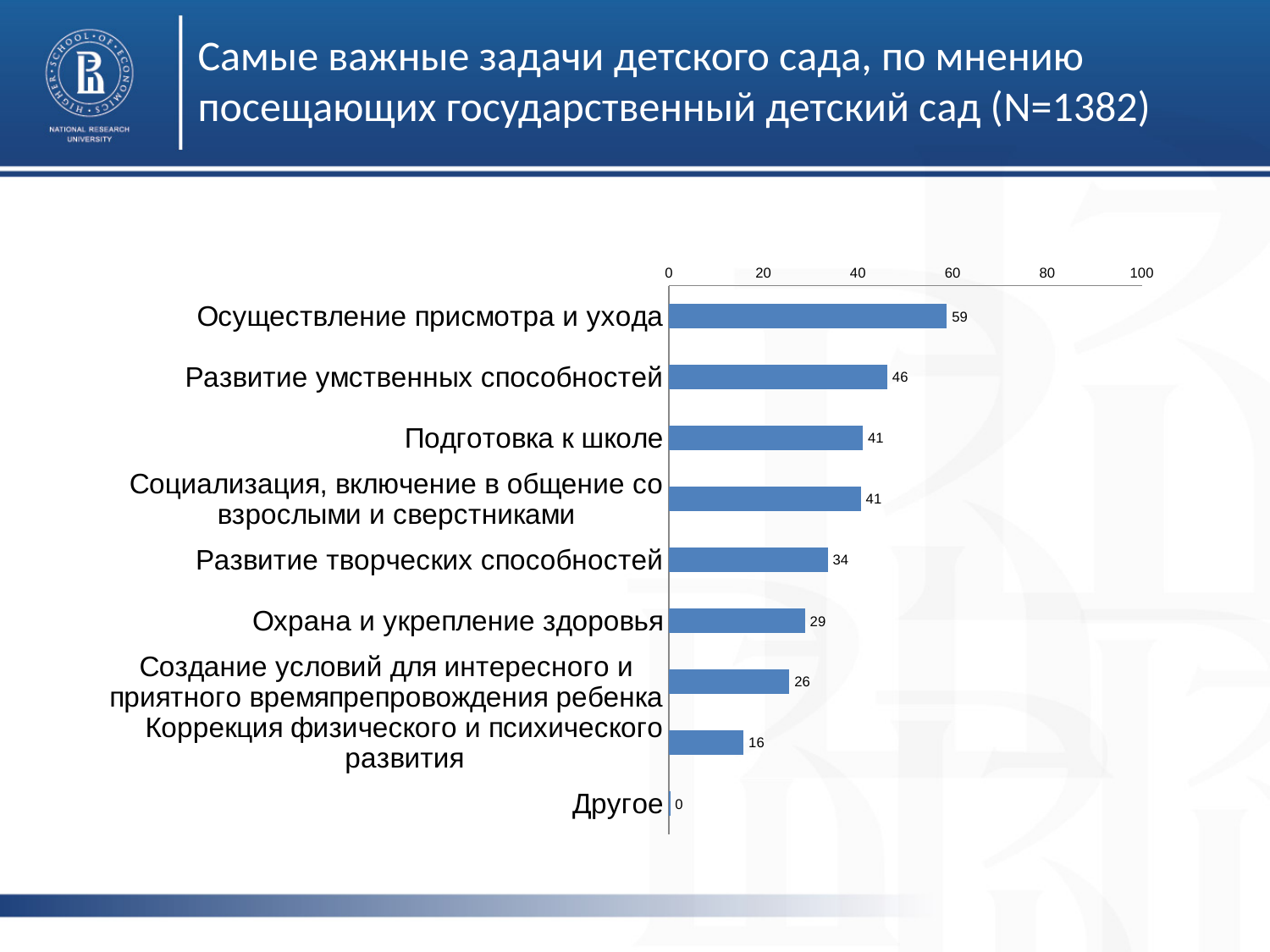
What is the value for «Осуществление присмотра и ухода»? 59 Is the value for «Подготовка к школе» greater or less than 40? greater What is the value for «Охрана и укрепление здоровья»? 29 What is the value for «Развитие умственных способностей»? 46 How many categories are shown in the chart? 9 Which category has the lowest value? Другое What is the maximum value shown on the horizontal axis? 100 What is the difference between the values for «Осуществление присмотра и ухода» and «Развитие умственных способностей»? 13 Which category has the highest value? Осуществление присмотра и ухода What kind of chart is shown on the slide? Bar chart Which is larger: the value for «Развитие творческих способностей» or the value for «Охрана и укрепление здоровья»? Развитие творческих способностей What is the value for «Коррекция физического и психического развития»? 16